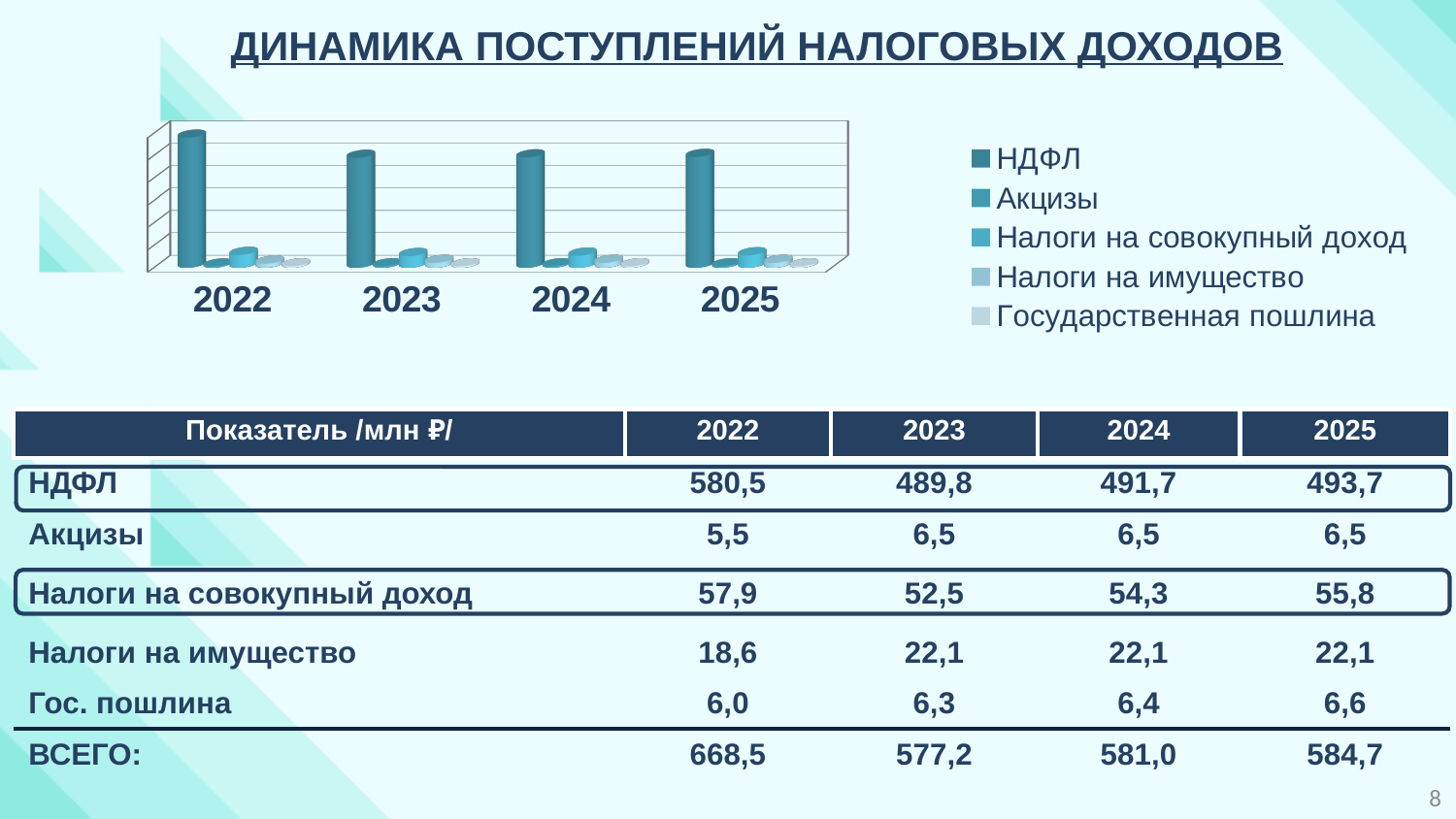
How many series does the chart legend list? 5 According to the table on the slide, what is the value of Налоги на совокупный доход for 2025? 55,8 Is the НДФЛ bar for 2022 taller or shorter than the НДФЛ bar for 2023? taller According to the table on the slide, what is the value of НДФЛ for 2022? 580,5 According to the table, what is the total (ВСЕГО) for 2025? 584,7 According to the table on the slide, what is the value of Налоги на имущество for 2023? 22,1 What is the last entry listed in the chart legend? Государственная пошлина Using the table values, what is the difference between НДФЛ in 2022 and НДФЛ in 2023? 90,7 Which series has the tallest bars in the chart? НДФЛ How many years are shown along the x axis of the chart? 4 In which year is the НДФЛ bar the tallest? 2022 What kind of chart is shown on the slide? bar chart